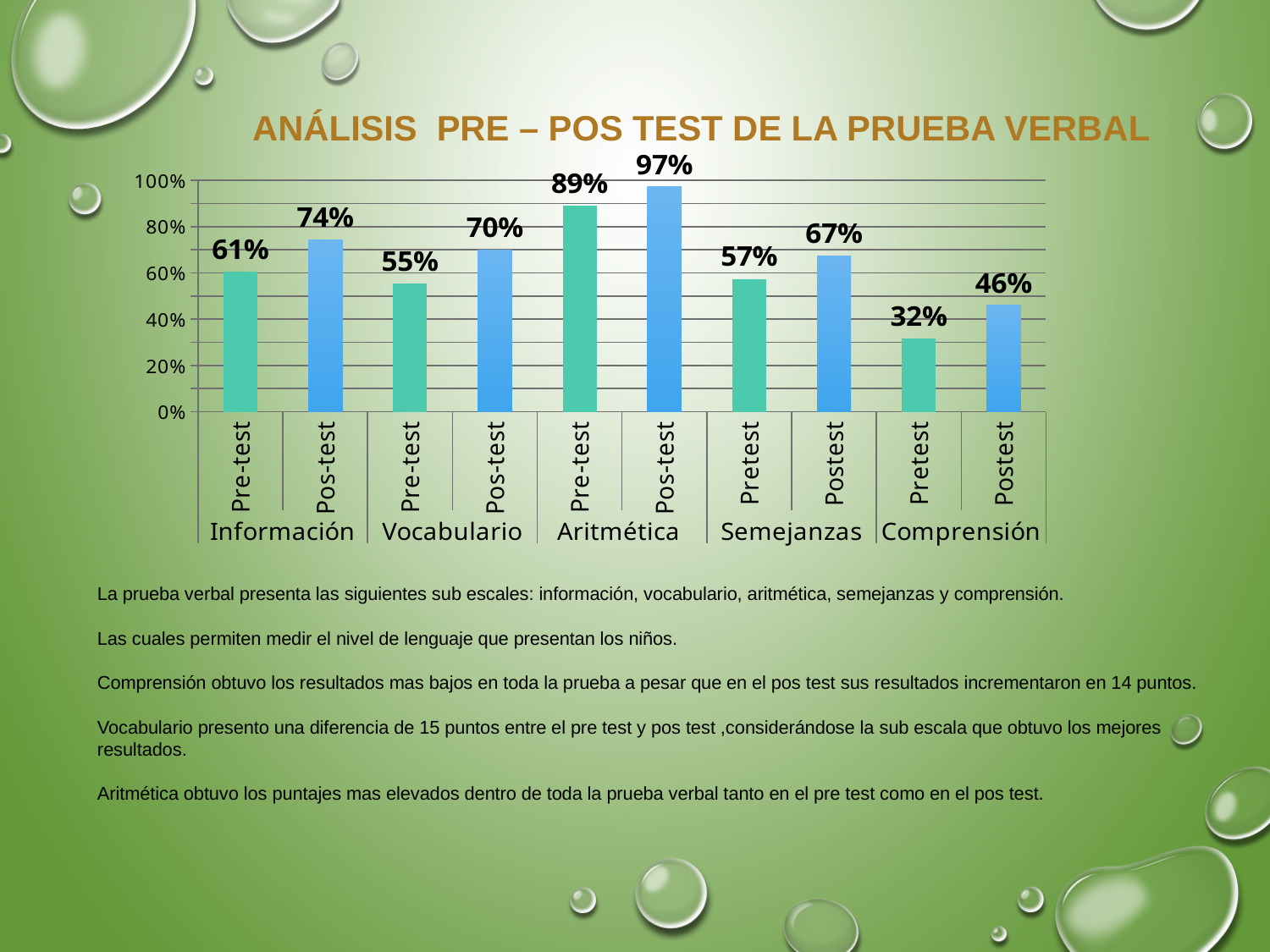
Which bar has the highest value in the chart? Aritmética Pos-test What is the title of the chart? ANÁLISIS PRE – POS TEST DE LA PRUEBA VERBAL What is the Pos-test value for Aritmética? 97% What is the difference between the Pos-test and Pre-test values for Información? 13% What type of chart is shown on the slide? Bar chart What is the Pretest value for Comprensión? 32% Which bar has the lowest value in the chart? Comprensión Pretest What is the difference between the Postest and Pretest values for Comprensión? 14% What is the Postest value for Semejanzas? 67% What is the Pre-test value for Vocabulario? 55% Which is larger, the Pos-test value for Vocabulario or the Postest value for Semejanzas? Pos-test value for Vocabulario How many bars are plotted in the chart? 10